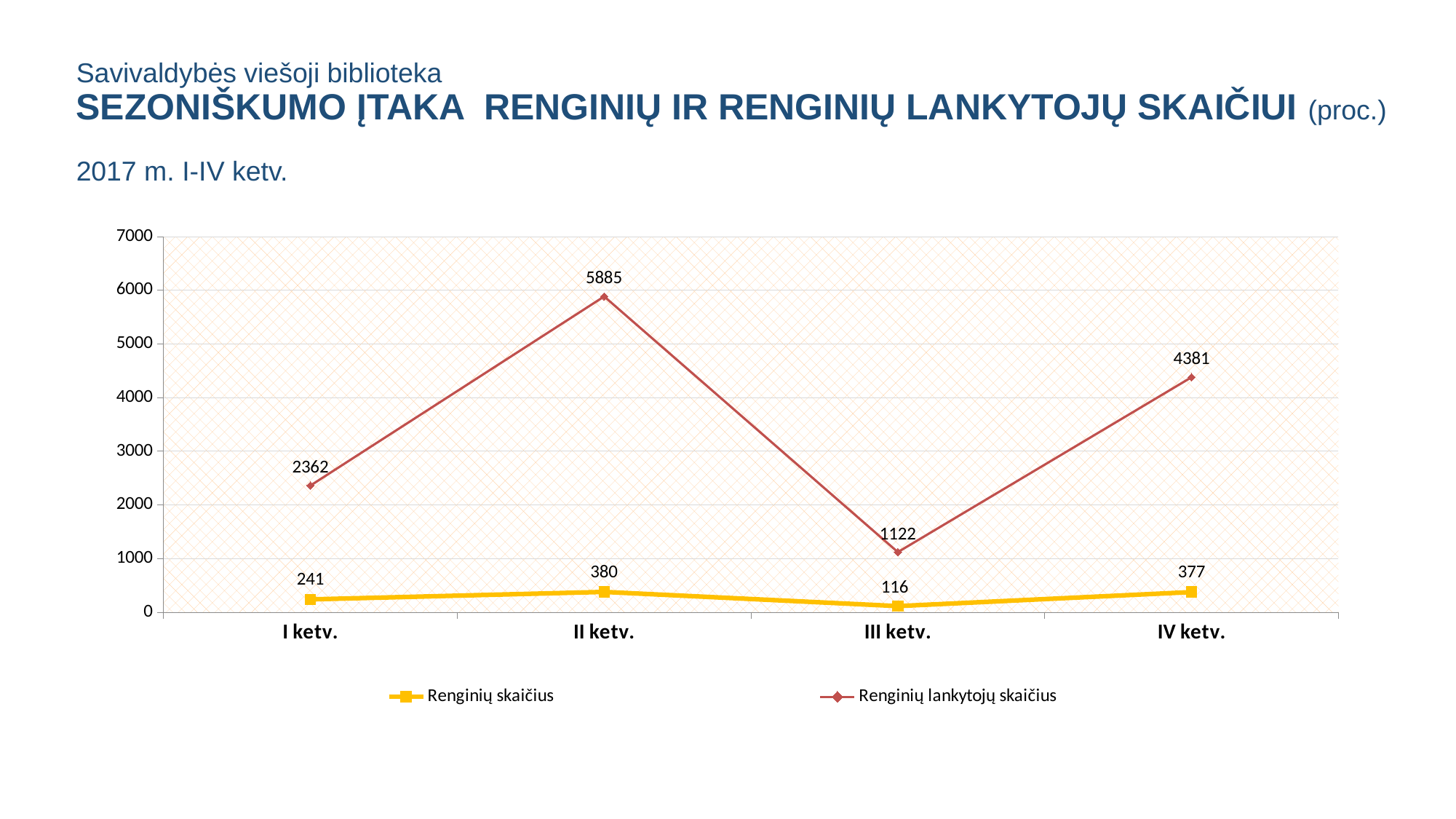
How many quarters are shown on the x axis? 4 What kind of chart is shown on the slide? line chart How many series does the legend list? 2 Is the value of Renginių lankytojų skaičius for I ketv. greater or less than 3000? less In which quarter is Renginių skaičius lowest? III ketv. What is the difference between Renginių skaičius in II ketv. and I ketv.? 139 In which quarter is Renginių lankytojų skaičius highest? II ketv. What is the value of Renginių skaičius for III ketv.? 116 Which is larger: Renginių skaičius in II ketv. or in IV ketv.? II ketv. What is the value of Renginių lankytojų skaičius for II ketv.? 5885 What is the difference between Renginių lankytojų skaičius in II ketv. and III ketv.? 4763 What is the value of Renginių lankytojų skaičius for IV ketv.? 4381